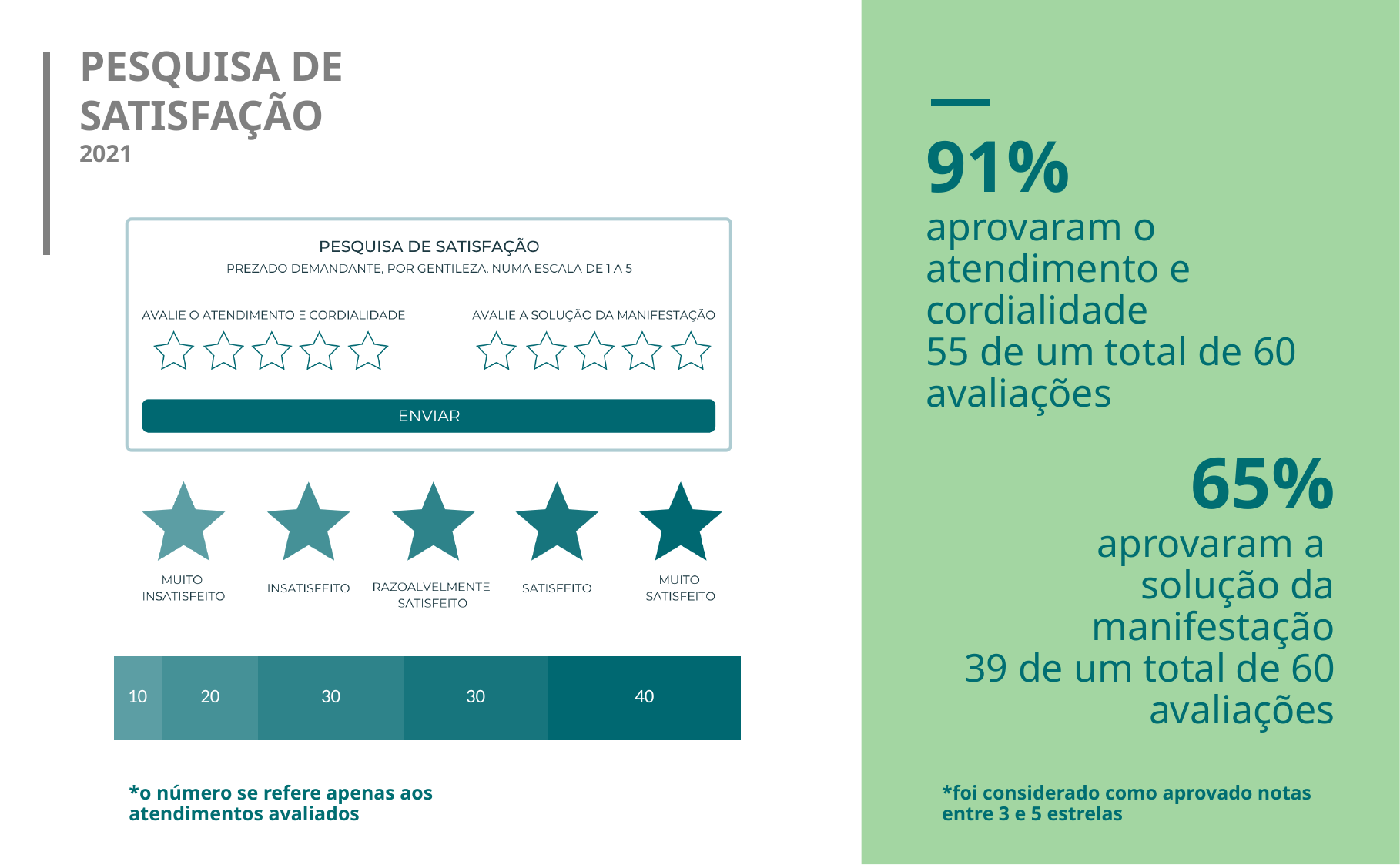
In the stacked bar at the bottom of the slide, what value is shown in the segment under "Insatisfeito"? 20 What is the total of all segments in the stacked bar at the bottom of the slide? 130 In the stacked bar at the bottom of the slide, which satisfaction level has the largest segment? Muito satisfeito In the stacked bar at the bottom of the slide, what is the difference between the "Muito satisfeito" segment and the "Muito insatisfeito" segment? 30 In the stacked bar at the bottom of the slide, which segment is larger: "Insatisfeito" or "Satisfeito"? Satisfeito In the stacked bar at the bottom of the slide, what value is shown in the segment under "Muito insatisfeito"? 10 What kind of chart is shown at the bottom of the slide? Stacked bar chart In the stacked bar at the bottom of the slide, what value is shown in the segment under "Muito satisfeito"? 40 In the stacked bar at the bottom of the slide, which satisfaction level has the smallest segment? Muito insatisfeito Do the segment values in the stacked bar rise or fall from left (Muito insatisfeito) to right (Muito satisfeito)? Rise How many segments does the stacked bar at the bottom of the slide have? 5 According to the slide, what percentage approved the "atendimento e cordialidade"? 91%